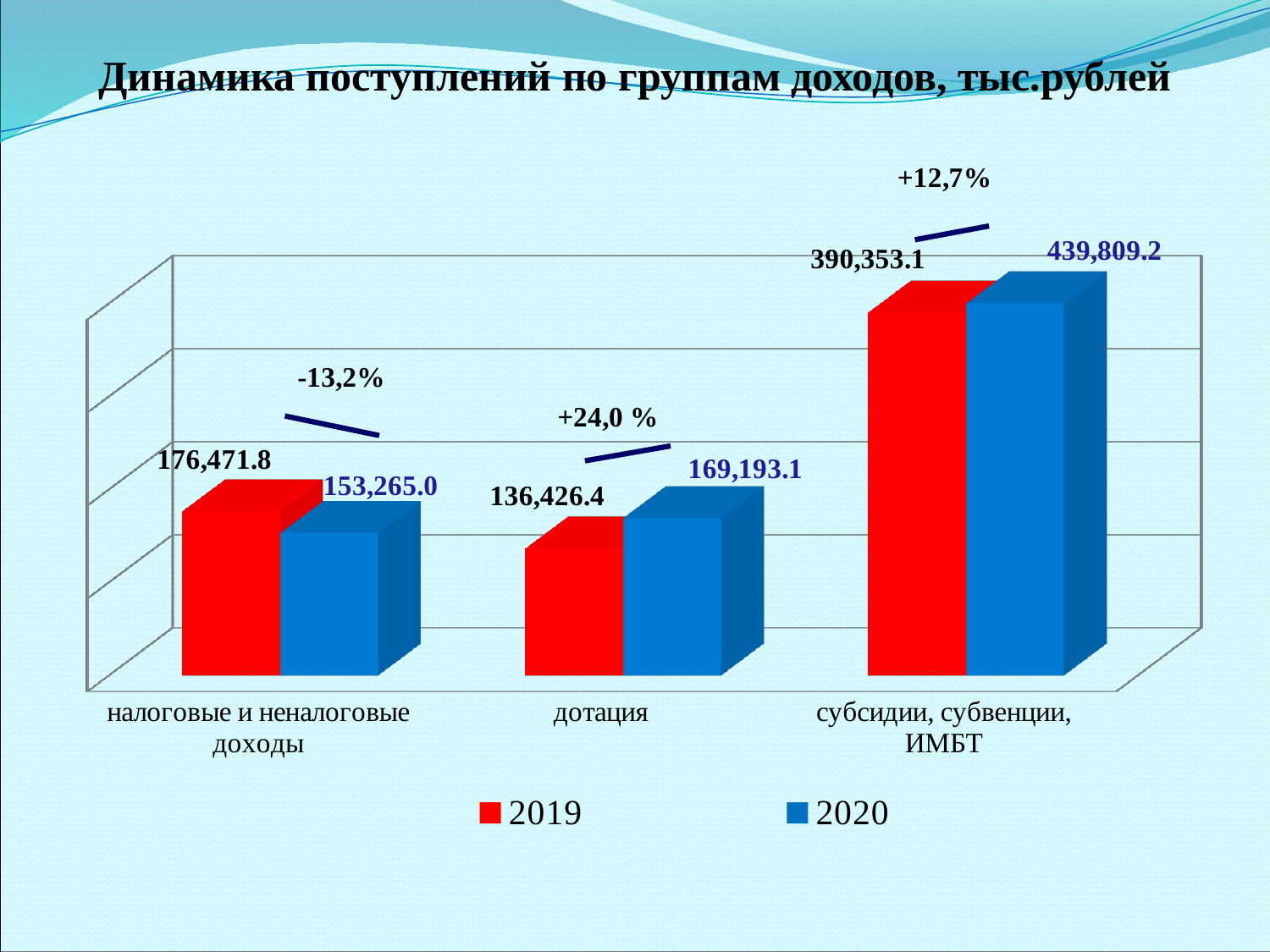
What is the difference between the 2020 and 2019 values for субсидии, субвенции, ИМБТ? 49,456.1 How many series does the legend list? 2 Which category has the highest 2020 value? субсидии, субвенции, ИМБТ What is the difference between the 2019 and 2020 values for налоговые и неналоговые доходы? 23,206.8 How many categories are shown on the x axis? 3 What is the 2020 value for дотация? 169,193.1 What is the 2020 value for субсидии, субвенции, ИМБТ? 439,809.2 What is the 2019 value for налоговые и неналоговые доходы? 176,471.8 For дотация, which year has the larger value, 2019 or 2020? 2020 What kind of chart is shown on the slide? bar chart Which category has the lowest 2019 value? дотация What is the 2019 value for дотация? 136,426.4